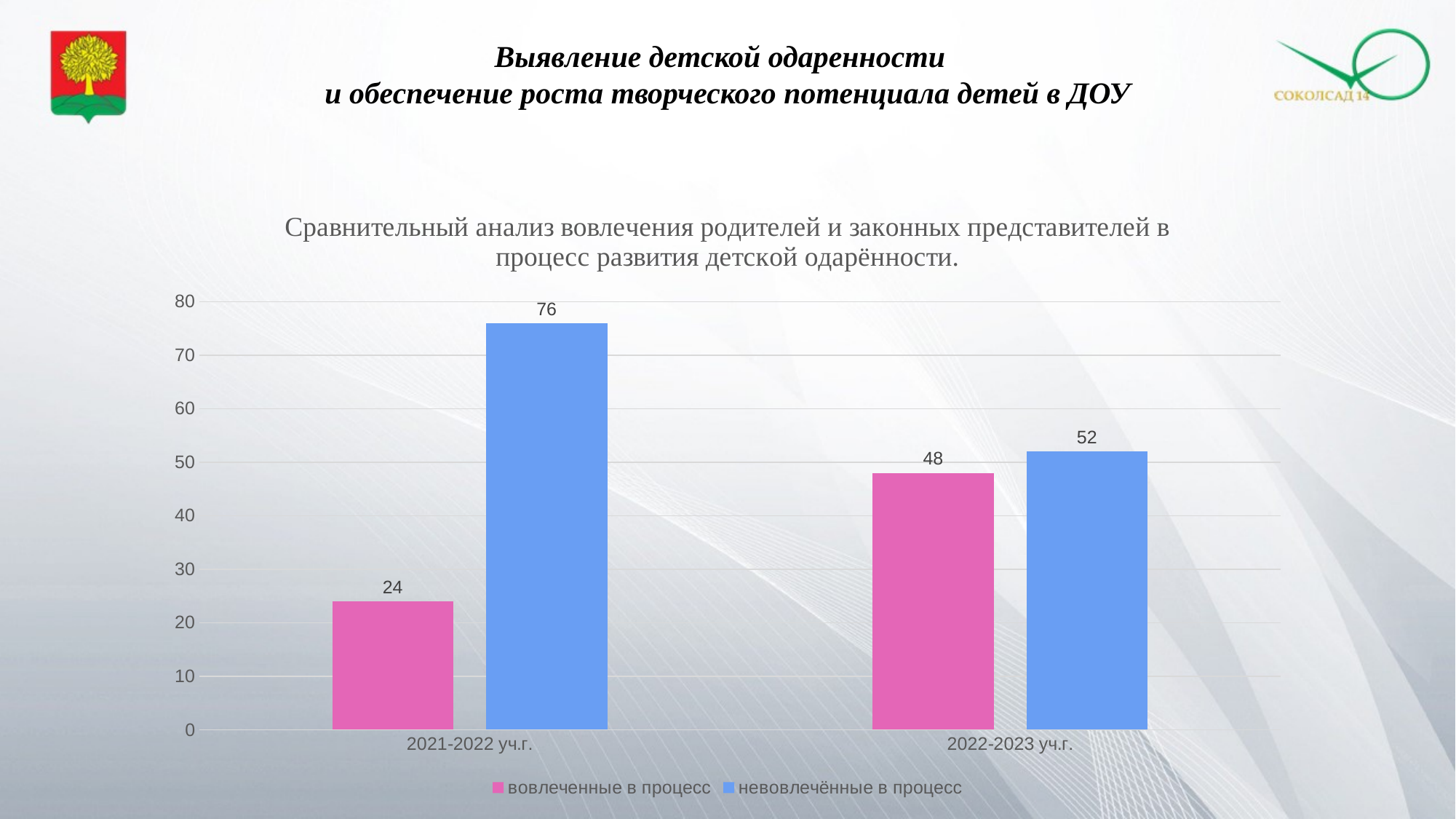
What is the value for 'невовлечённые в процесс' in 2021-2022 уч.г.? 76 Does the value for 'вовлеченные в процесс' rise or fall from 2021-2022 уч.г. to 2022-2023 уч.г.? rise What is the value for 'невовлечённые в процесс' in 2022-2023 уч.г.? 52 What is the value for 'вовлеченные в процесс' in 2022-2023 уч.г.? 48 What is the value for 'вовлеченные в процесс' in 2021-2022 уч.г.? 24 By how much did 'вовлеченные в процесс' increase from 2021-2022 уч.г. to 2022-2023 уч.г.? 24 Which is larger in 2022-2023 уч.г.: 'вовлеченные в процесс' or 'невовлечённые в процесс'? невовлечённые в процесс What kind of chart is shown on the slide? bar chart How many series does the legend list? 2 Which bar has the highest value on the chart? невовлечённые в процесс, 2021-2022 уч.г. Which bar has the lowest value on the chart? вовлеченные в процесс, 2021-2022 уч.г. What is the difference between 'невовлечённые в процесс' and 'вовлеченные в процесс' in 2021-2022 уч.г.? 52